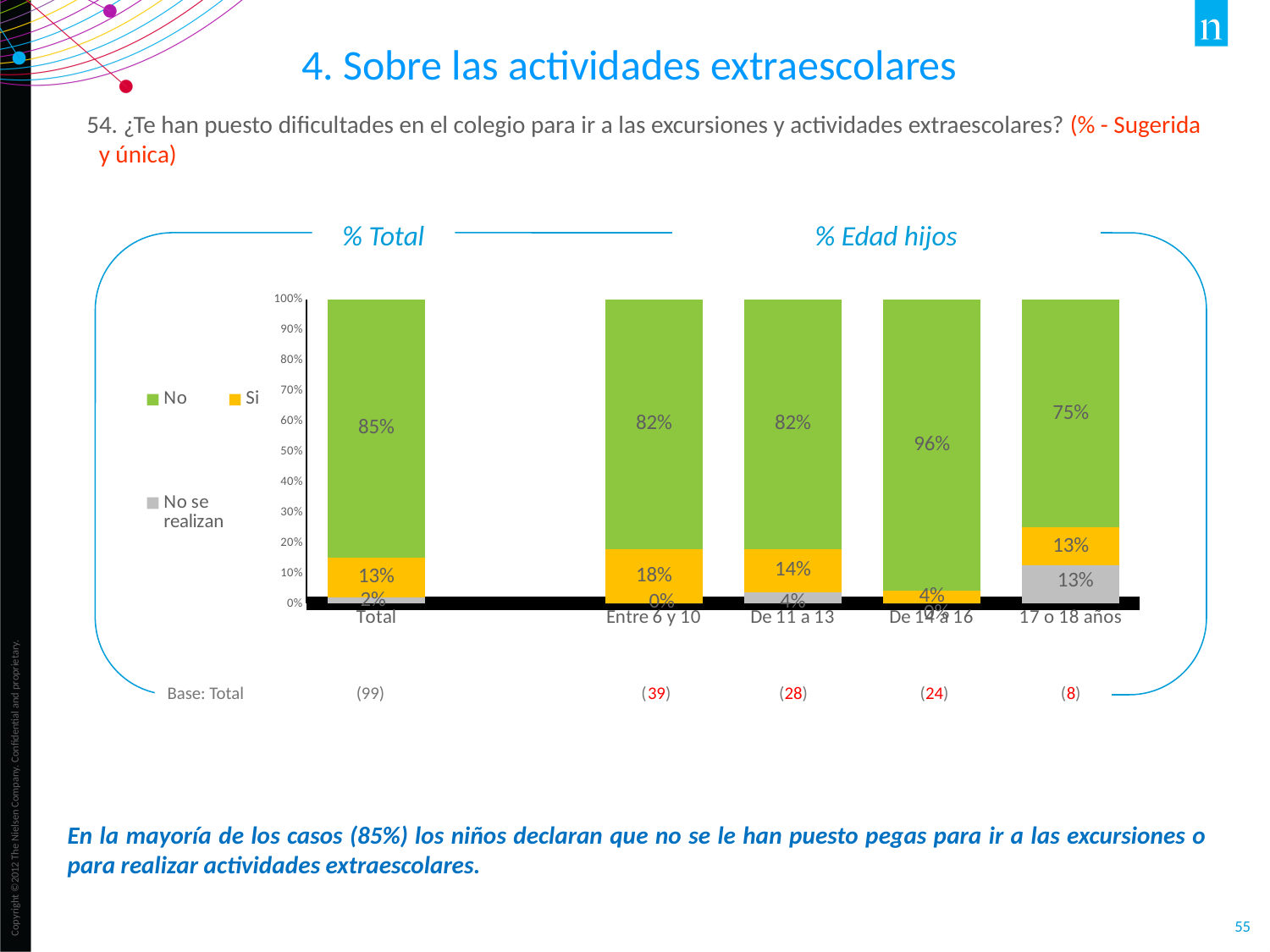
Which age group has the lowest "No" percentage? 17 o 18 años Which series is shown in green in the chart? No What is the "Si" value for the "Entre 6 y 10" age group? 18% What is the "No" value for the "De 14 a 16" age group? 96% What percentage of children in the Total group answered "No"? 85% What type of chart is shown on the slide? Stacked bar chart How many categories are shown on the x axis of the chart? 5 What is the difference in percentage points between the "No" value for "De 14 a 16" and for "17 o 18 años"? 21 percentage points Which age group has the highest "No" percentage? De 14 a 16 Which has a larger "Si" value: "Entre 6 y 10" or "De 11 a 13"? Entre 6 y 10 How many series does the legend list? 3 What is the "No se realizan" value for the "17 o 18 años" age group? 13%